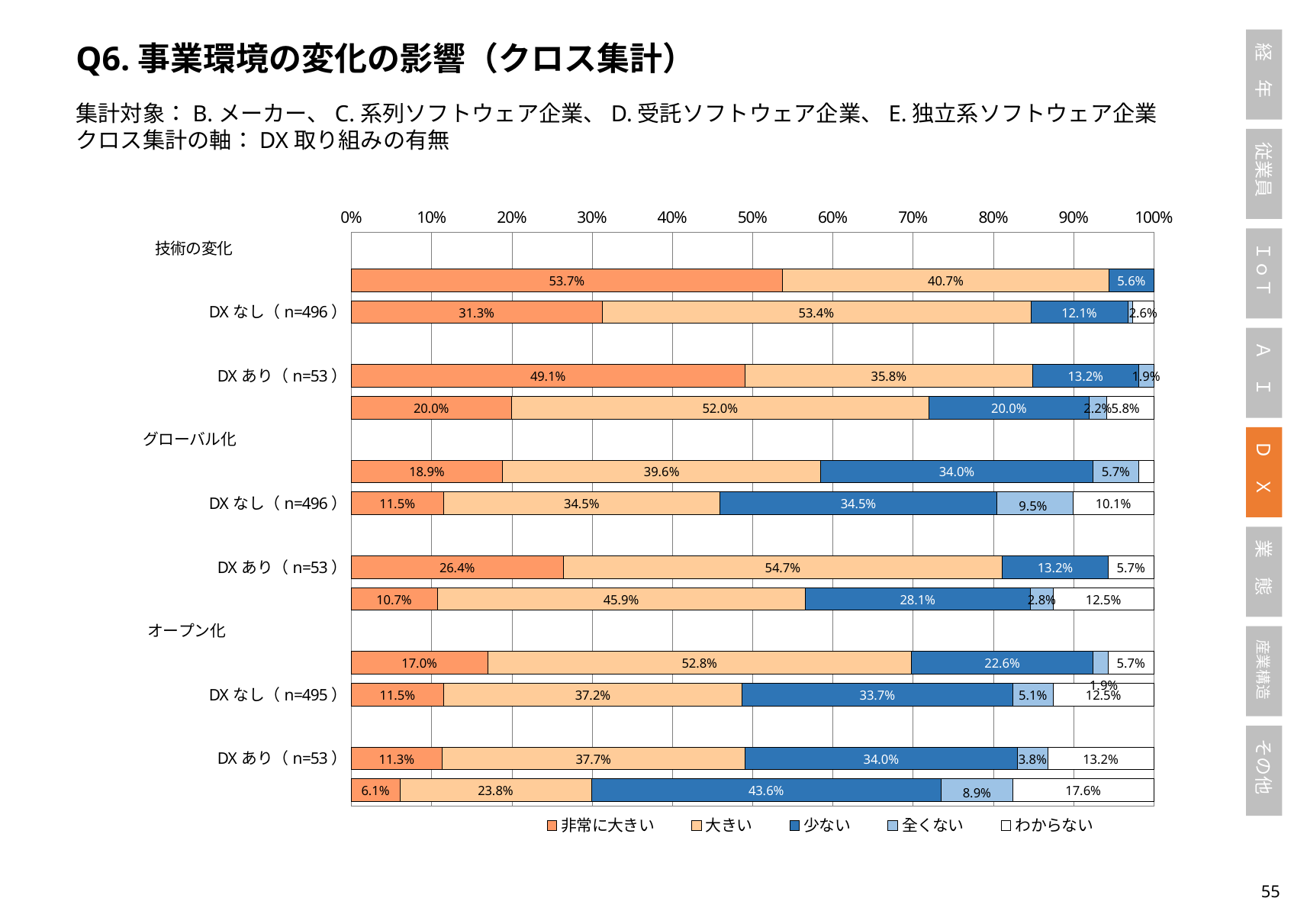
In the グローバル化 group, what is the わからない value for the bar labelled DX なし (n=496)? 10.1% How many series does the legend of the chart list? 5 What is the first entry in the chart's legend? 非常に大きい How many category groups (such as 技術の変化) are shown on the vertical axis of the chart? 3 In the グローバル化 group, what is the 大きい value for the bar labelled DX あり (n=53)? 54.7% In the 技術の変化 group, what is the 非常に大きい value for the bar labelled DX なし (n=496)? 31.3% In the 技術の変化 group, which has the larger 非常に大きい share: the bar labelled DX あり (n=53) or the bar labelled DX なし (n=496)? DX あり (n=53) In the オープン化 group, what is the 少ない value for the bar labelled DX なし (n=495)? 33.7% In the 技術の変化 group, what is the difference in the 非常に大きい share between the bar labelled DX あり (n=53) and the bar labelled DX なし (n=496)? 17.8 percentage points In the 技術の変化 group, what is the 非常に大きい value for the bar labelled DX あり (n=53)? 49.1% In the オープン化 group, what is the わからない value for the bar labelled DX あり (n=53)? 13.2% What kind of chart is shown on the slide? Stacked bar chart